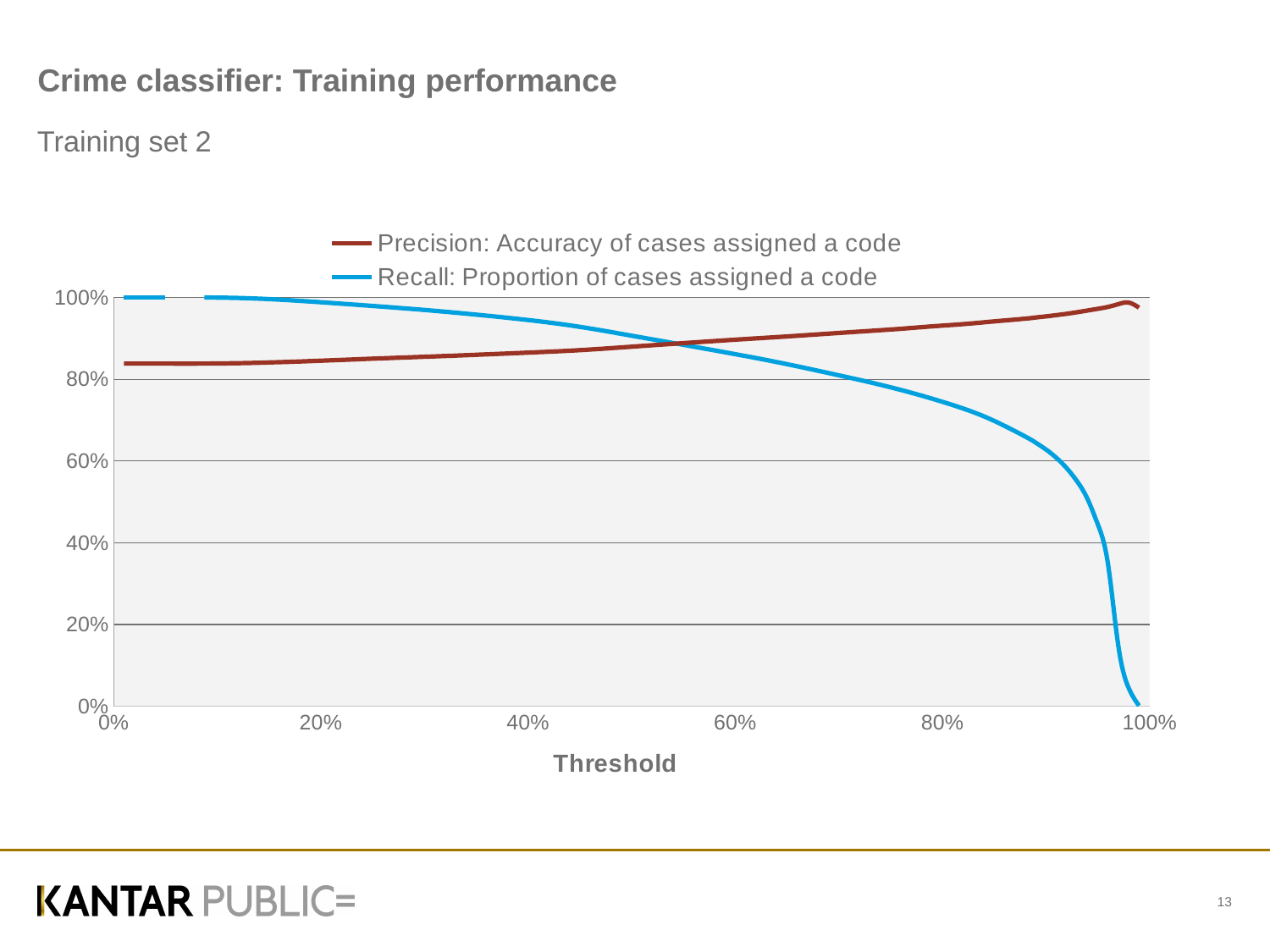
At a threshold of 20%, which series has the higher value, Precision or Recall? Recall What colour is the line for Recall: Proportion of cases assigned a code? Blue What is the label of the x axis? Threshold How many series does the legend list? 2 Is the Recall value at a threshold of 100% greater or less than 20%? less Is the Recall value at a threshold of 40% greater or less than 80%? greater Is the Recall value at a threshold of 80% greater or less than 60%? greater At a threshold of 80%, which series has the higher value, Precision or Recall? Precision What kind of chart is shown on the slide? Line chart Does the Recall line rise or fall as the threshold increases along the x axis? Falls Does the Precision line rise or fall as the threshold increases along the x axis? Rises